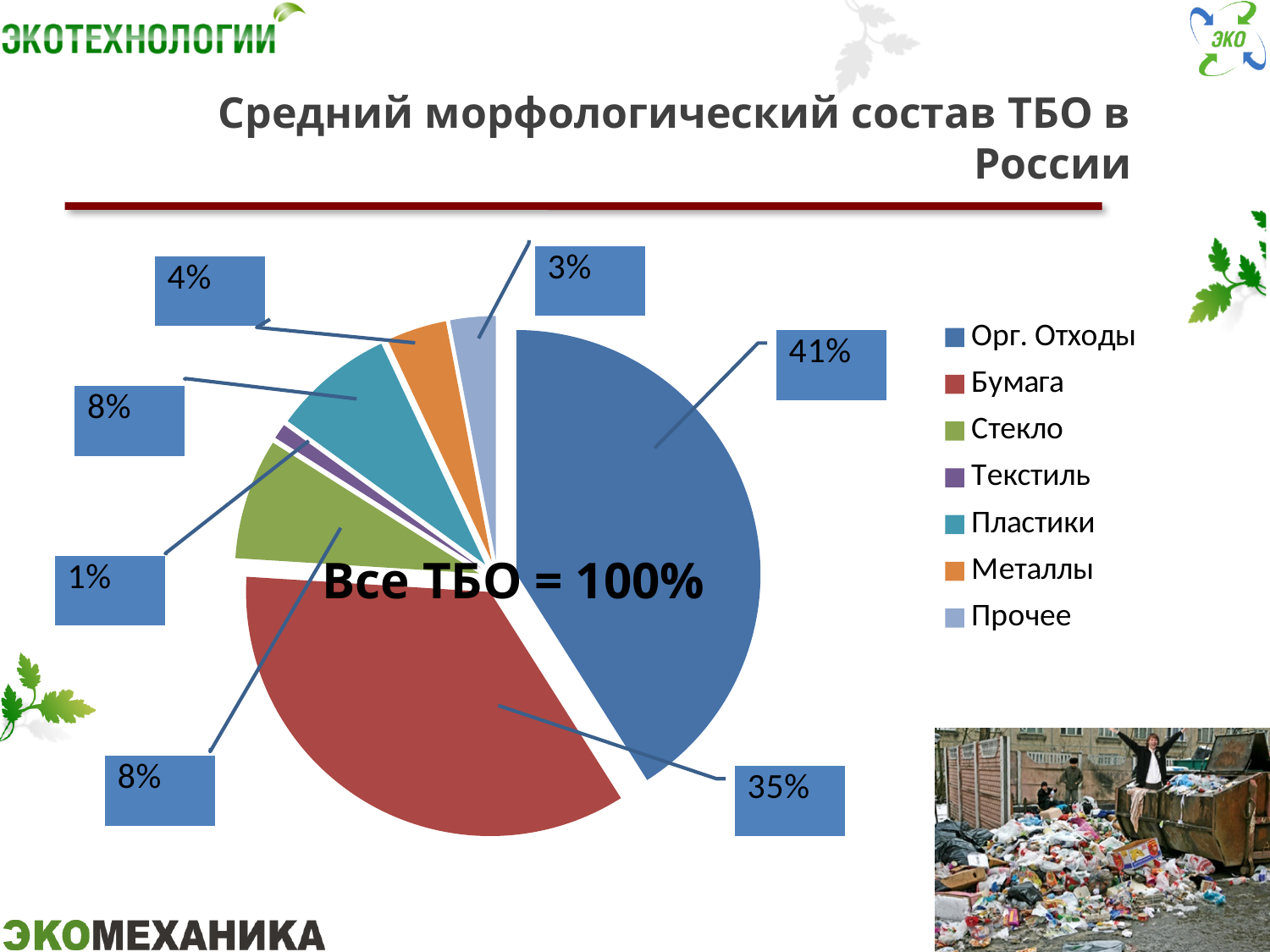
Which is larger, the share for Металлы or the share for Прочее? Металлы Which category has the largest slice of the pie? Орг. Отходы What share of the pie does Металлы have? 4% What share of the pie does Прочее have? 3% Which category has the smallest slice of the pie? Текстиль What kind of chart is shown on the slide? pie chart What share of the pie does Текстиль have? 1% What is the difference in percentage points between Орг. Отходы and Бумага? 6 What is the title of the chart on the slide? Средний морфологический состав ТБО в России What share of the pie does Бумага have? 35% What share of the pie does Орг. Отходы have? 41% How many categories does the legend list? 7